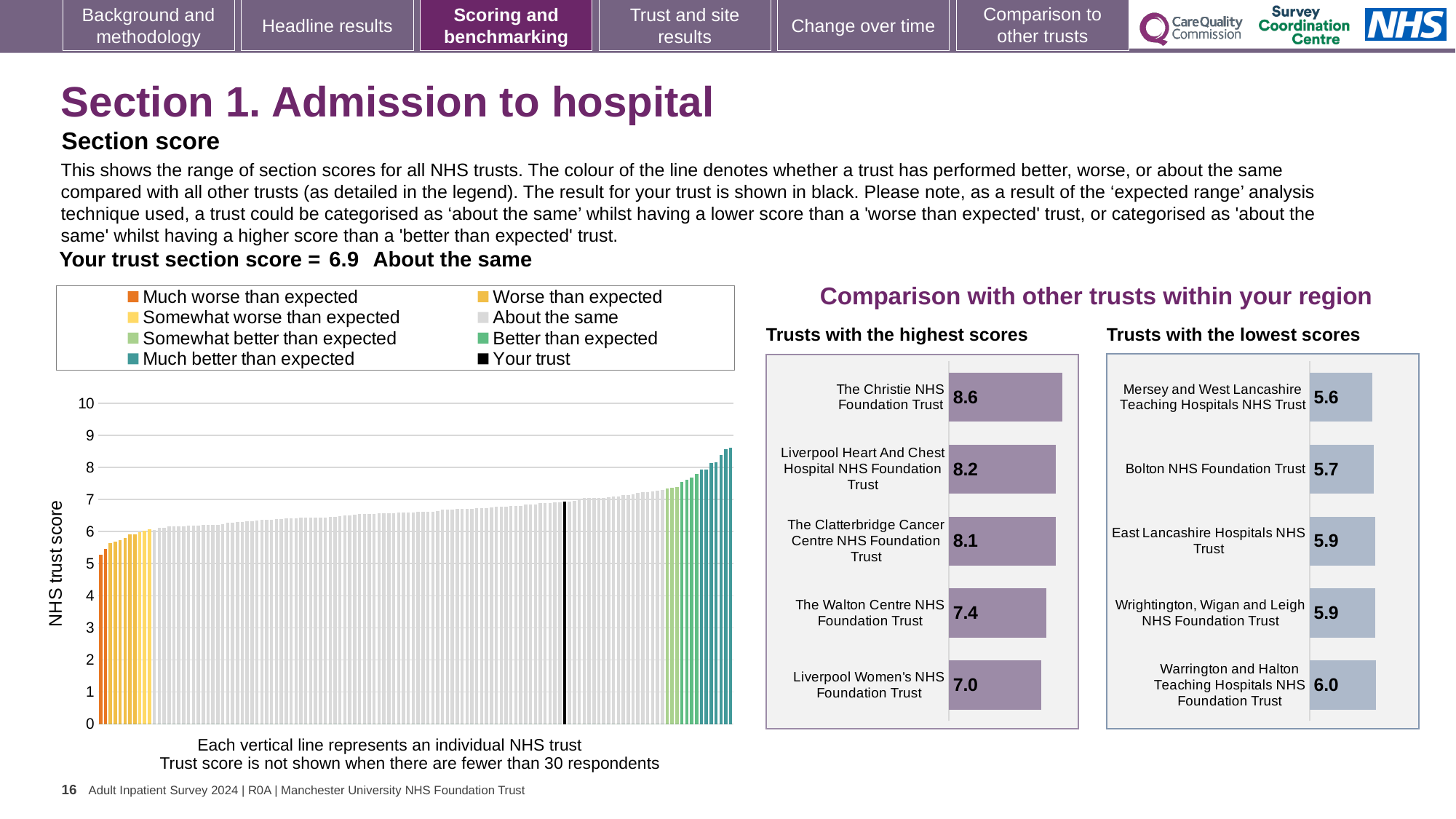
How many entries does the legend of the main NHS trust score chart list? 8 How many trusts are shown in the 'Trusts with the highest scores' chart? 5 In the main NHS trust score chart, do the trust scores rise or fall from left to right? rise In the 'Trusts with the highest scores' chart, what is the score for The Christie NHS Foundation Trust? 8.6 What is the section score for your trust shown on the slide? 6.9 In the 'Trusts with the lowest scores' chart, what is the difference between the scores of Warrington and Halton Teaching Hospitals NHS Foundation Trust and Mersey and West Lancashire Teaching Hospitals NHS Trust? 0.4 In the 'Trusts with the highest scores' chart, what is the difference between the scores of The Christie NHS Foundation Trust and Liverpool Women's NHS Foundation Trust? 1.6 In the 'Trusts with the highest scores' chart, which trust has the highest score? The Christie NHS Foundation Trust What kind of chart is the main NHS trust score chart on the left? bar chart In the 'Trusts with the lowest scores' chart, what is the score for Bolton NHS Foundation Trust? 5.7 In the 'Trusts with the lowest scores' chart, which trust has the lowest score? Mersey and West Lancashire Teaching Hospitals NHS Trust In the 'Trusts with the highest scores' chart, which has the larger score: The Walton Centre NHS Foundation Trust or Liverpool Women's NHS Foundation Trust? The Walton Centre NHS Foundation Trust